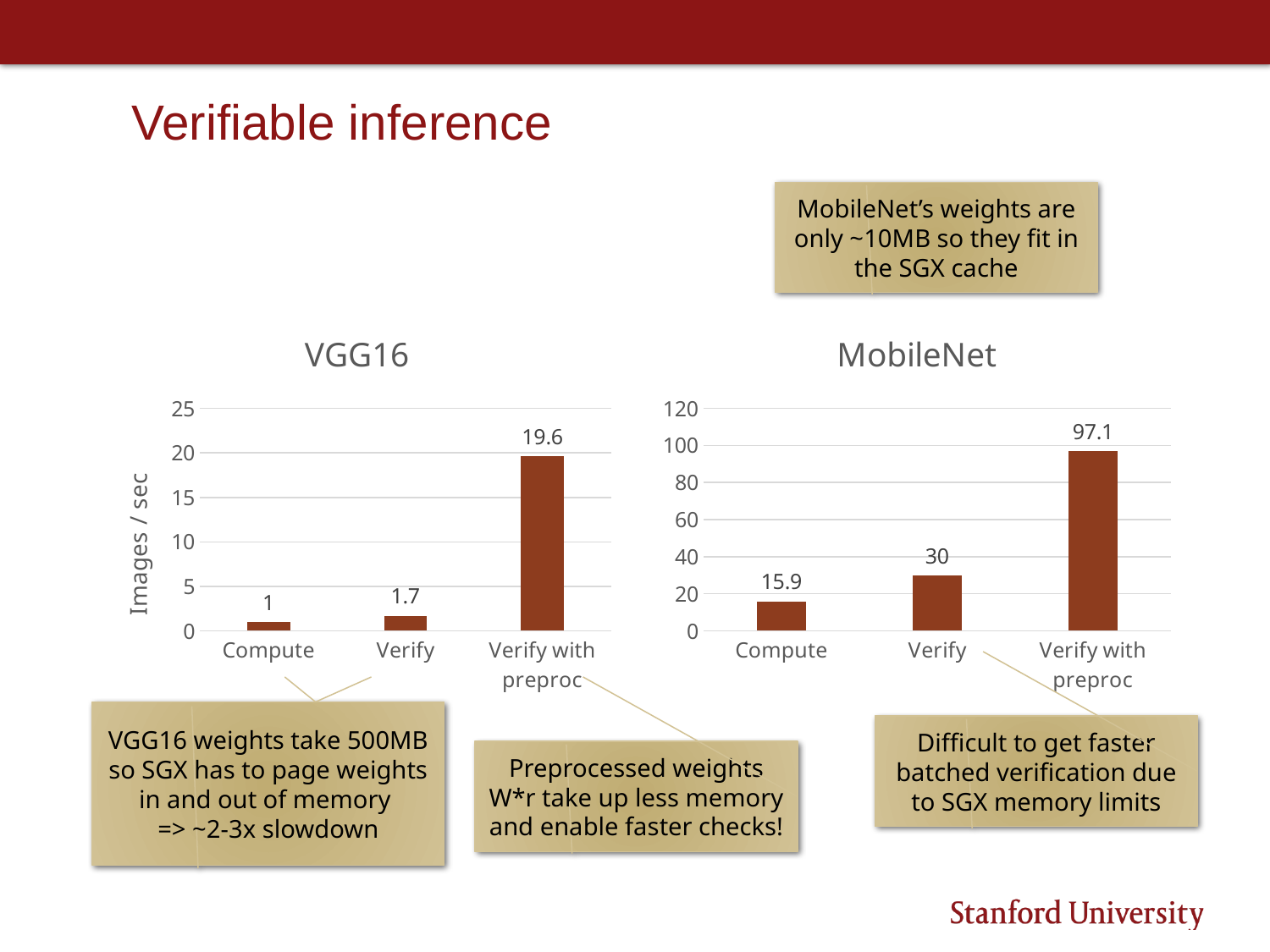
In the MobileNet chart, is the value for Verify with preproc greater or less than 80? greater In the MobileNet chart, which category has the highest value? Verify with preproc What kind of chart is the MobileNet chart? bar chart How many categories does the VGG16 chart show? 3 In the MobileNet chart, what is the value for Verify? 30 What is the y-axis label of the VGG16 chart? Images / sec In the VGG16 chart, what is the value for Verify with preproc? 19.6 In the MobileNet chart, which is larger, Verify or Compute? Verify In the VGG16 chart, which category has the lowest value? Compute In the VGG16 chart, what is the difference between Verify with preproc and Verify? 17.9 In the MobileNet chart, what is the value for Compute? 15.9 In the MobileNet chart, what is the difference between Verify and Compute? 14.1